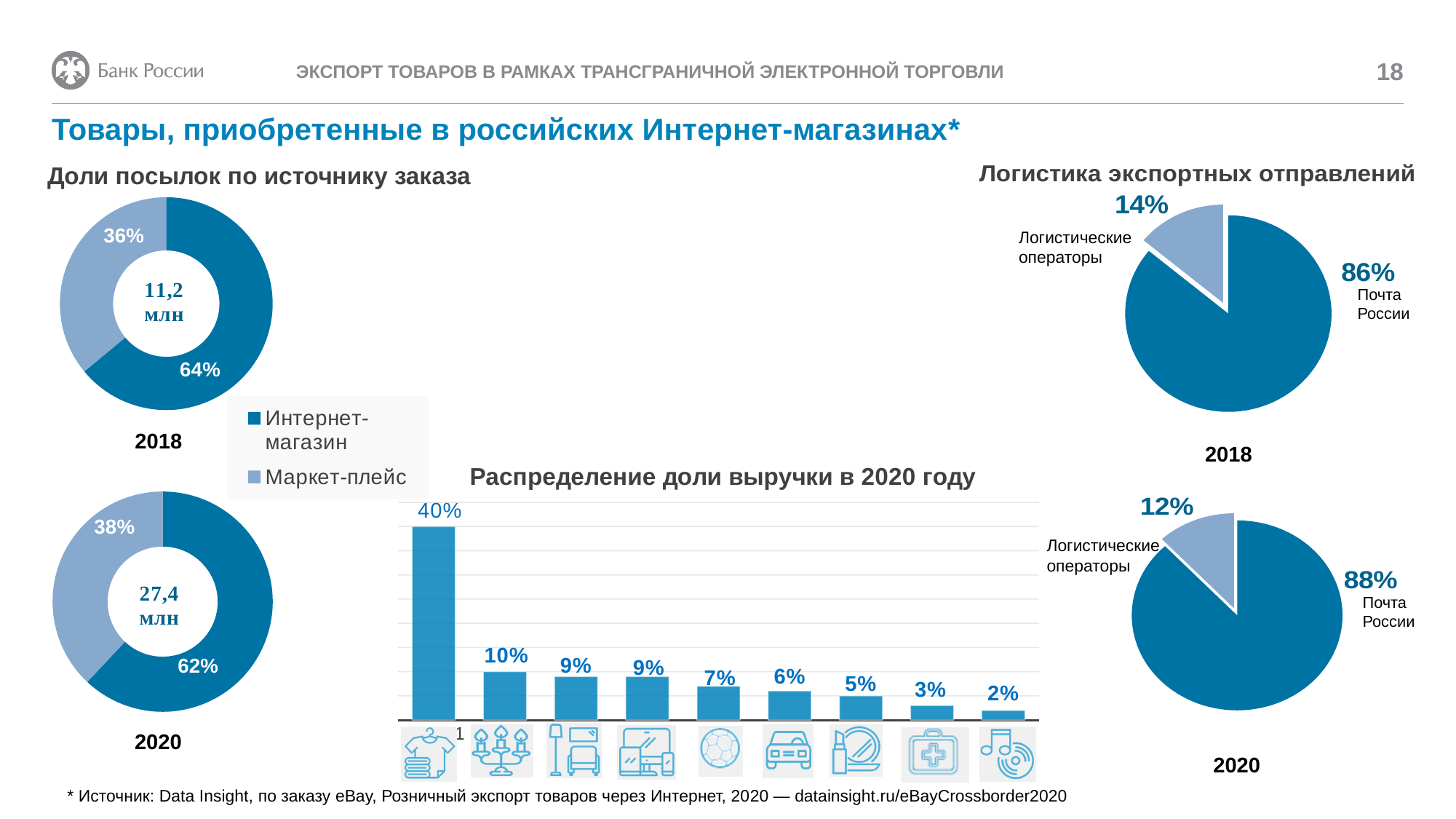
How many bars are in the chart "Распределение доли выручки в 2020 году"? 9 In the 2020 donut chart under "Доли посылок по источнику заказа", what is the difference between the Интернет-магазин share and the Маркет-плейс share? 24% In the 2018 pie chart under "Логистика экспортных отправлений", what share is shown for Почта России? 86% What kind of chart is "Распределение доли выручки в 2020 году"? bar chart In the "Логистика экспортных отправлений" charts, which is larger: the Логистические операторы share in 2018 or in 2020? 2018 How many series does the legend of the "Доли посылок по источнику заказа" charts list? 2 In the 2018 donut chart under "Доли посылок по источнику заказа", what share is shown for Интернет-магазин? 64% In the chart "Распределение доли выручки в 2020 году", what is the value of the tallest bar? 40% In the 2018 donut chart under "Доли посылок по источнику заказа", what share is shown for Маркет-плейс? 36% What total value is printed in the centre of the 2020 donut chart under "Доли посылок по источнику заказа"? 27,4 млн In the 2020 donut chart under "Доли посылок по источнику заказа", what share is shown for Маркет-плейс? 38% In the 2020 pie chart under "Логистика экспортных отправлений", what share is shown for Логистические операторы? 12%